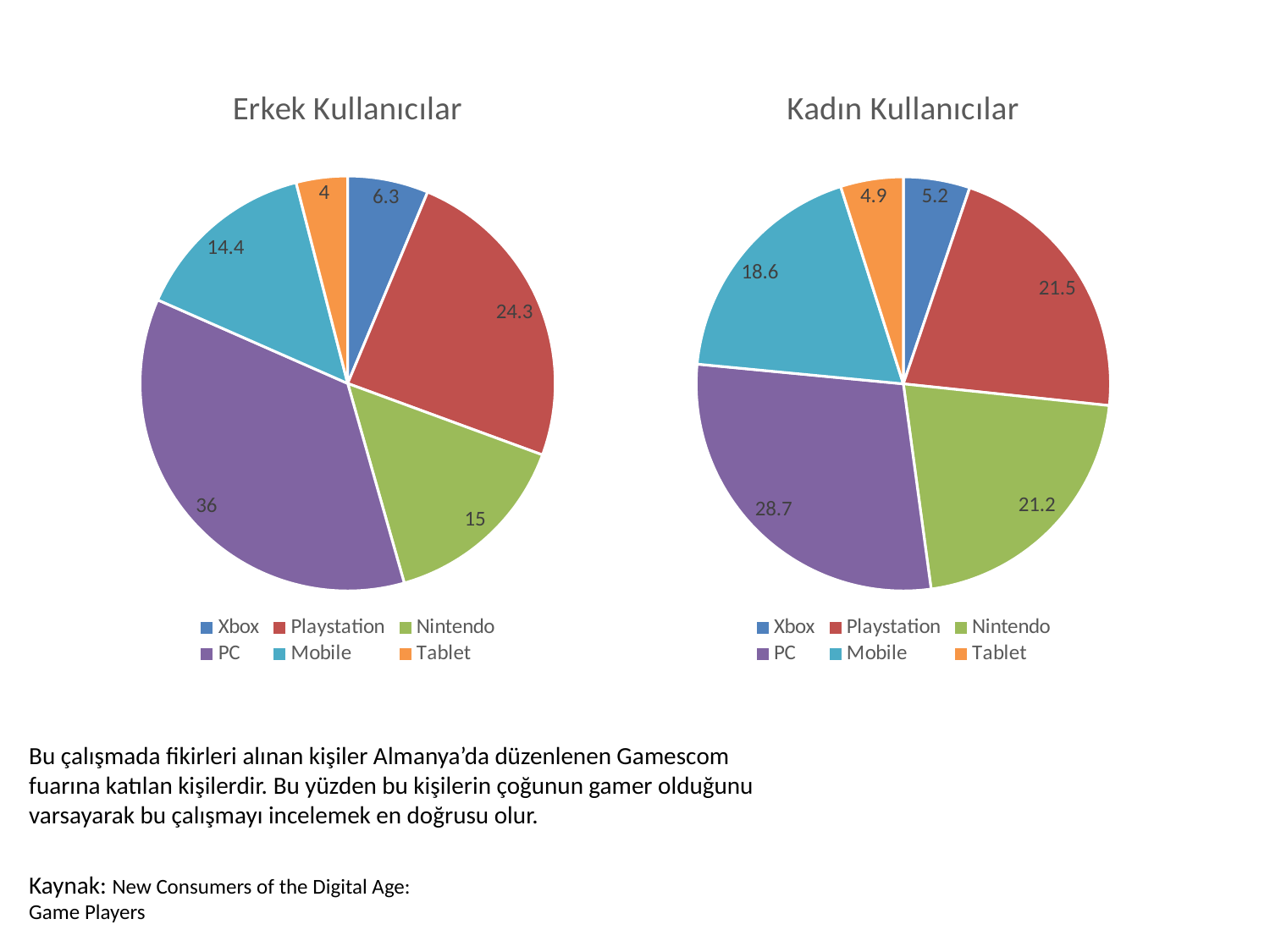
What type of chart is the Erkek Kullanıcılar chart? Pie chart In the Kadın Kullanıcılar chart, which category has the smallest slice? Tablet In the Erkek Kullanıcılar chart, which is larger, Nintendo or Mobile? Nintendo In the Kadın Kullanıcılar chart, what is the difference between the Playstation and Nintendo values? 0.3 In the Kadın Kullanıcılar chart, which category has the largest slice? PC In the Erkek Kullanıcılar chart, what is the difference between the PC and Playstation values? 11.7 In the Erkek Kullanıcılar chart, what is the value for Playstation? 24.3 How many categories does the Kadın Kullanıcılar chart show? 6 In the Erkek Kullanıcılar chart, what is the value for PC? 36 In the Kadın Kullanıcılar chart, what is the value for Mobile? 18.6 In the Kadın Kullanıcılar chart, which colour represents Mobile? Teal (light blue) In the Erkek Kullanıcılar chart, which category has the smallest slice? Tablet